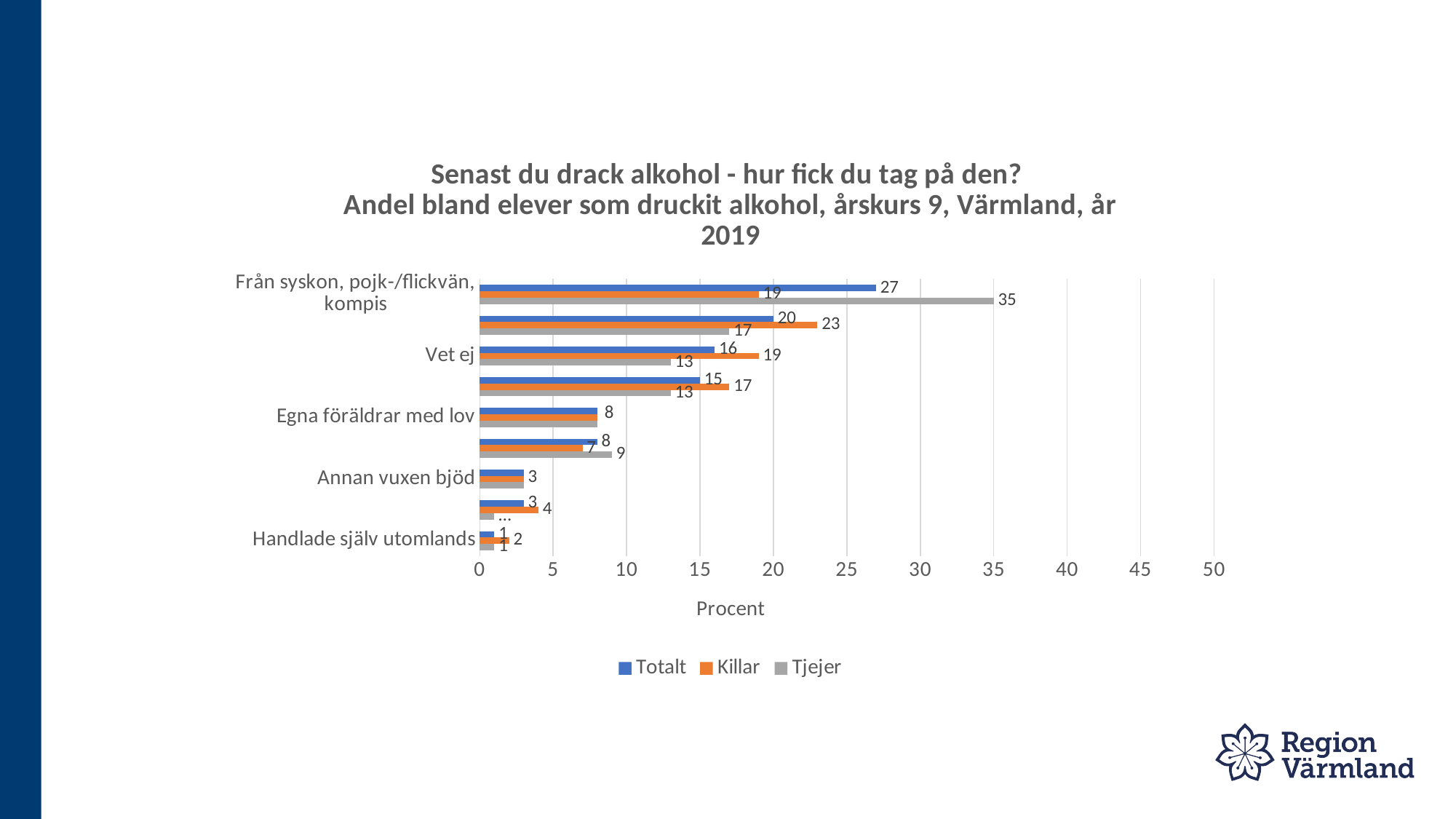
What is the value for Killar in the category 'Handlade själv utomlands'? 2 What kind of chart is shown on the slide? bar chart In the category 'Vet ej', which is larger: Killar or Tjejer? Killar What is the value for Killar in the category 'Vet ej'? 19 Which series has the highest value in the category 'Från syskon, pojk-/flickvän, kompis'? Tjejer What are the three entries in the legend? Totalt, Killar, Tjejer How many series does the legend list? 3 What is the value for Totalt in the category 'Från syskon, pojk-/flickvän, kompis'? 27 What is the title of the horizontal axis? Procent What is the difference between the Tjejer and Killar values for 'Från syskon, pojk-/flickvän, kompis'? 16 What is the value for Tjejer in the category 'Från syskon, pojk-/flickvän, kompis'? 35 Is the Totalt value for 'Vet ej' greater or less than 20? less